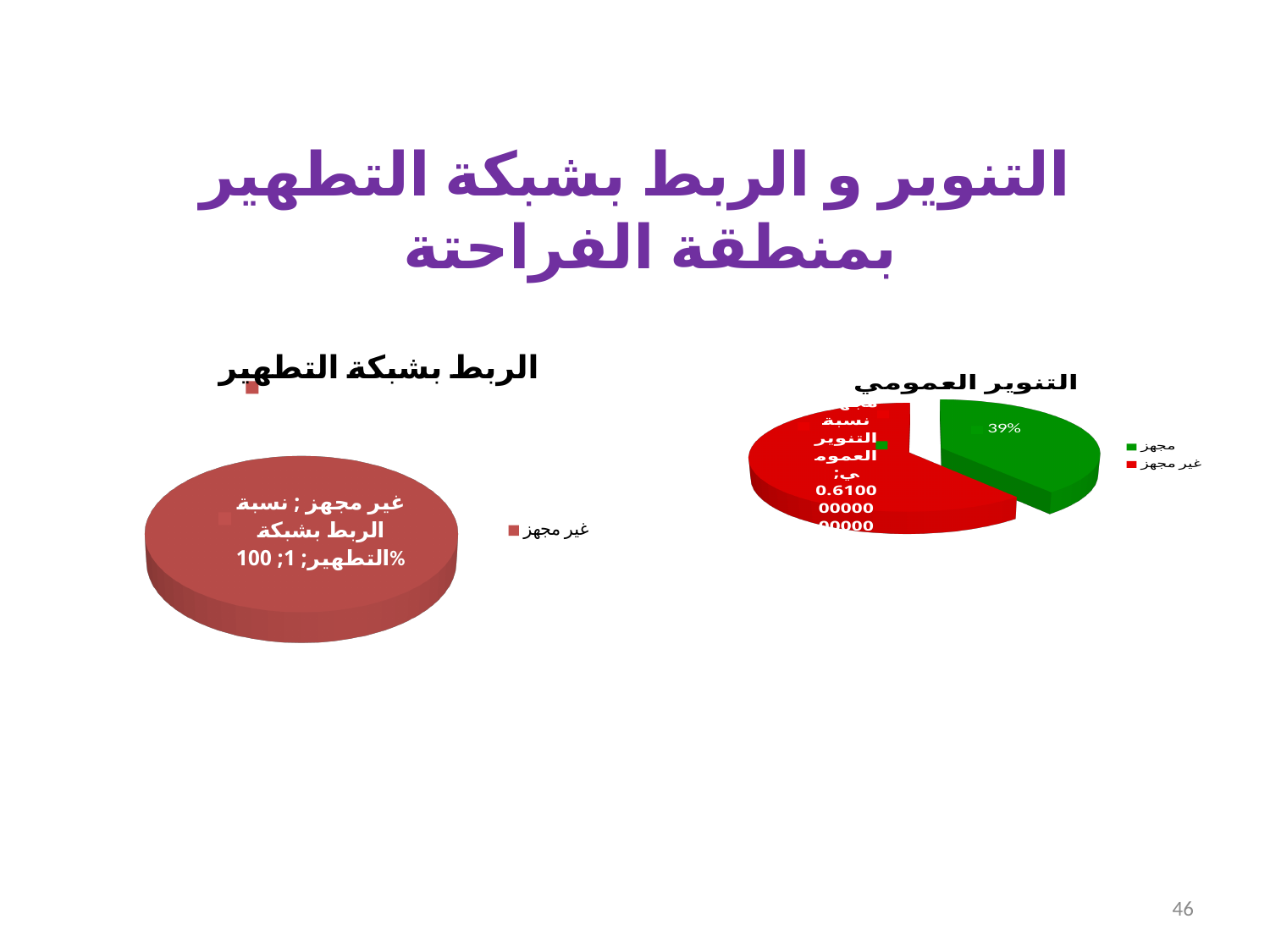
In the chart titled التنوير العمومي, which is larger, مجهز or غير مجهز? غير مجهز In the chart titled التنوير العمومي, how many entries does the legend list? 2 In the chart titled الربط بشبكة التطهير, how many slices does the pie have? 1 In the chart titled الربط بشبكة التطهير, how many entries does the legend list? 1 In the chart titled التنوير العمومي, what colour is the slice for مجهز? green What kind of chart is the chart titled التنوير العمومي on the right of the slide? pie chart In the chart titled التنوير العمومي, how many slices does the pie have? 2 In the chart titled التنوير العمومي, what is the value shown for مجهز? 39% In the chart titled التنوير العمومي, which category has the smallest slice? مجهز In the chart titled الربط بشبكة التطهير, what percentage is shown for غير مجهز? 100% What kind of chart is the chart titled الربط بشبكة التطهير on the left of the slide? pie chart In the chart titled التنوير العمومي, which category has the largest slice? غير مجهز